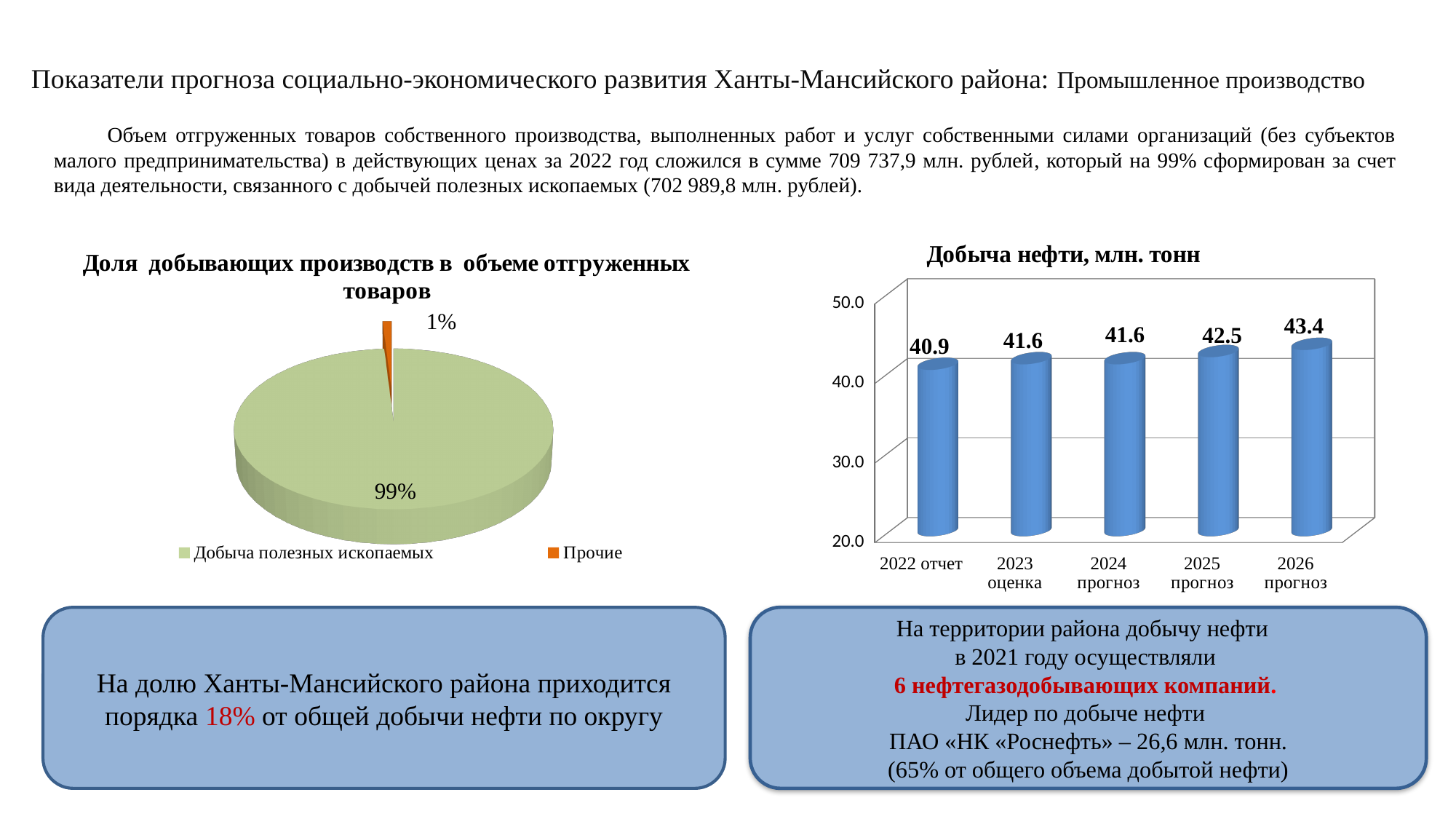
In the chart 'Добыча нефти, млн. тонн', what is the value for 2025 прогноз? 42.5 What kind of chart is 'Добыча нефти, млн. тонн'? bar chart In the chart 'Добыча нефти, млн. тонн', what is the value for 2022 отчет? 40.9 In the pie chart 'Доля добывающих производств в объеме отгруженных товаров', what share does 'Прочие' have? 1% In the chart 'Добыча нефти, млн. тонн', do the values rise or fall from 2022 to 2026? rise In the chart 'Добыча нефти, млн. тонн', what is the value for 2026 прогноз? 43.4 In the chart 'Добыча нефти, млн. тонн', which category has the lowest value? 2022 отчет In the pie chart 'Доля добывающих производств в объеме отгруженных товаров', what share does 'Добыча полезных ископаемых' have? 99% How many entries does the legend of the pie chart 'Доля добывающих производств в объеме отгруженных товаров' list? 2 In the chart 'Добыча нефти, млн. тонн', which category has the highest value? 2026 прогноз In the chart 'Добыча нефти, млн. тонн', how many categories are shown on the x axis? 5 In the chart 'Добыча нефти, млн. тонн', what is the difference between the values for 2026 прогноз and 2022 отчет? 2.5